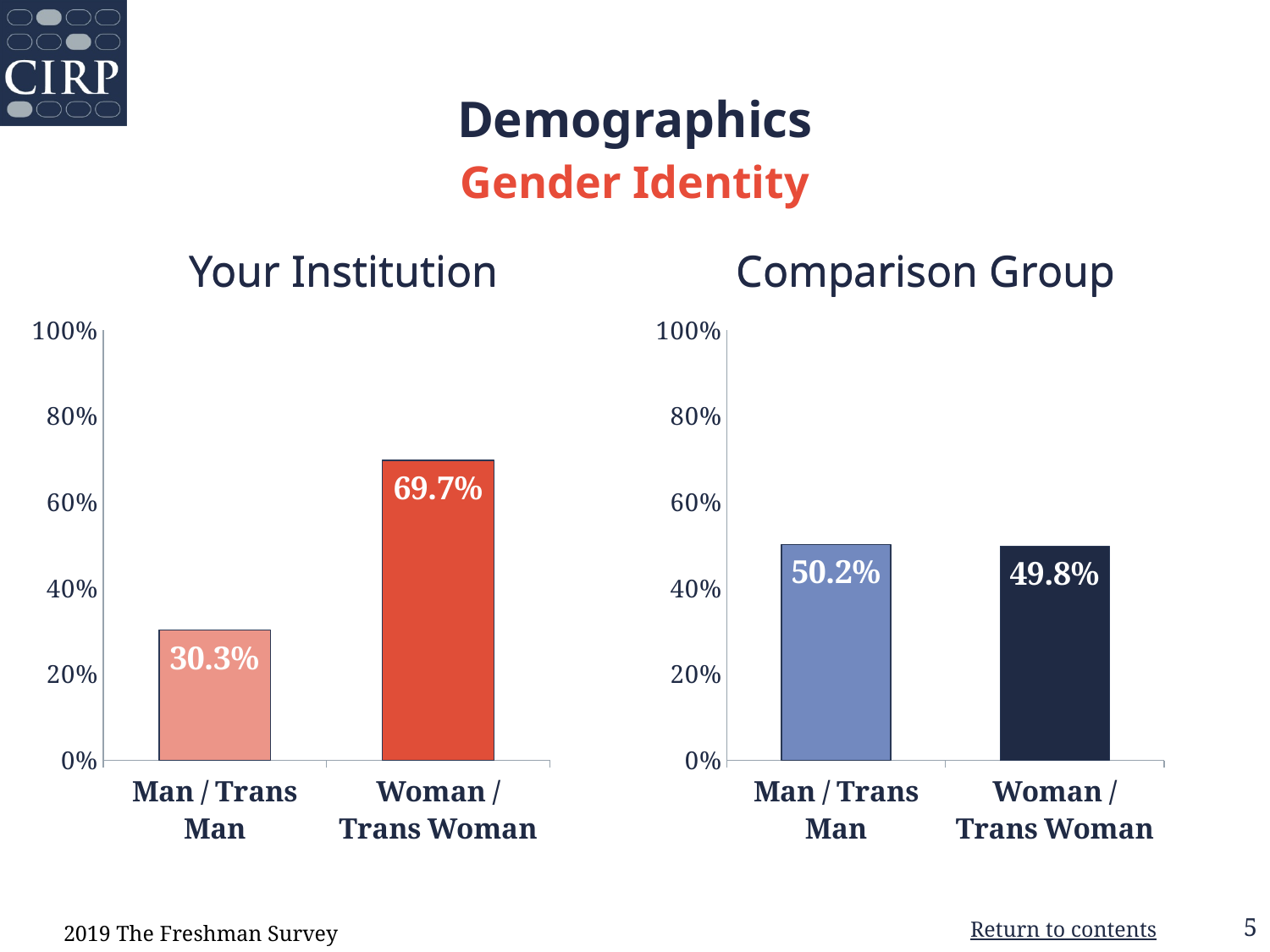
In the Comparison Group chart, what is the difference between the Man / Trans Man and Woman / Trans Woman values? 0.4% In the Comparison Group chart, what is the value for Woman / Trans Woman? 49.8% In the Your Institution chart, which category has the highest value? Woman / Trans Woman In the Your Institution chart, what is the value for Woman / Trans Woman? 69.7% In the Your Institution chart, which category has the lowest value? Man / Trans Man Is the Man / Trans Man value in the Your Institution chart greater or less than 40%? less In the Comparison Group chart, what is the value for Man / Trans Man? 50.2% How many categories are shown in the Comparison Group chart? 2 In the Your Institution chart, what is the value for Man / Trans Man? 30.3% In the Your Institution chart, what is the difference between the Woman / Trans Woman and Man / Trans Man values? 39.4% What is the title of the chart on the right side of the slide? Comparison Group What kind of chart is the Your Institution chart? bar chart